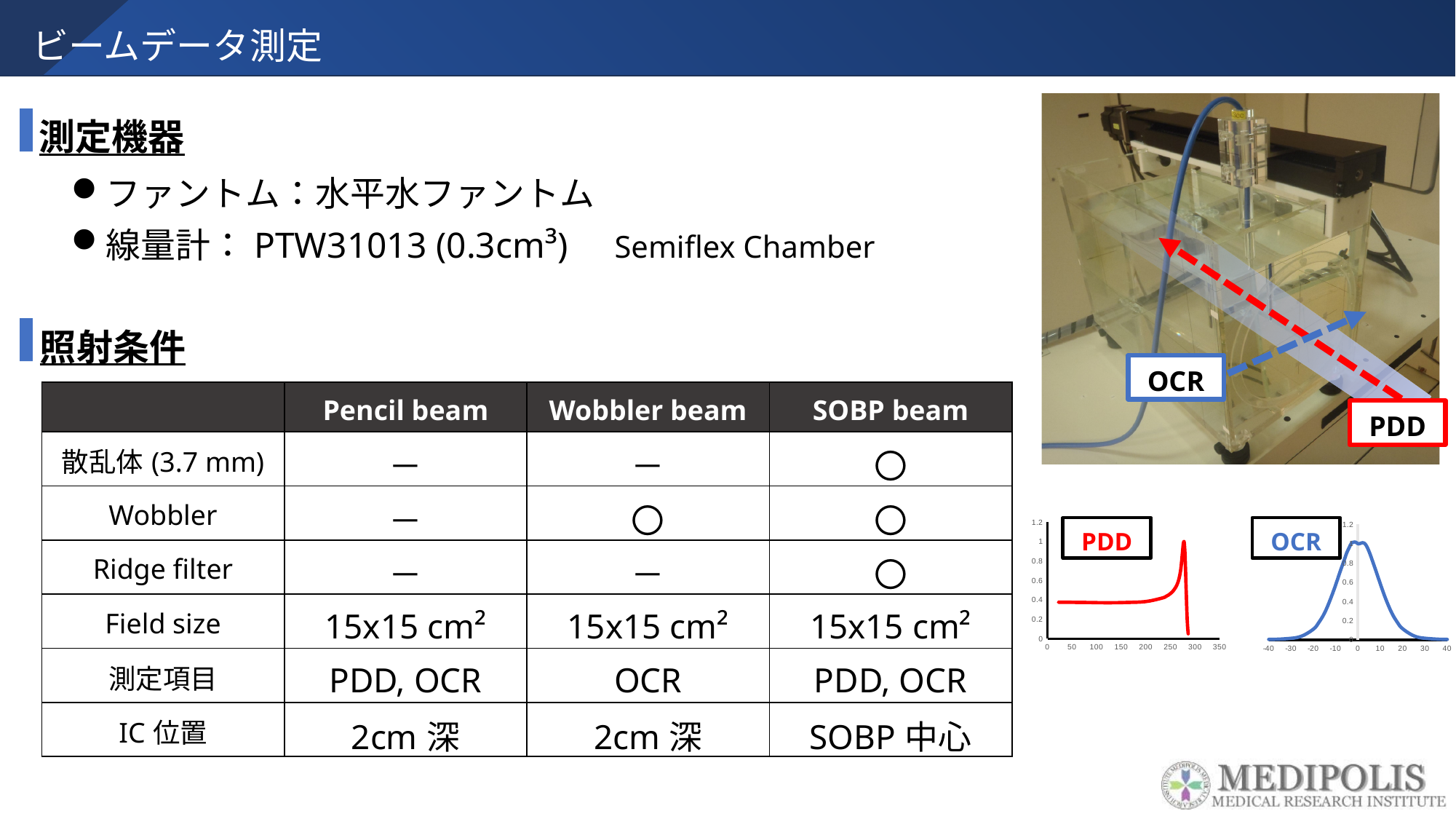
What is the largest x-axis tick value shown on the PDD chart? 350 What kind of chart is the OCR chart? line chart In the PDD chart, is the value at x = 50 greater or less than 0.6? less In the PDD chart, does the curve rise or fall as x increases from 0 to about 250? rise In the OCR chart, does the curve rise or fall as x increases from 0 to 40? fall How many charts are shown on the slide? 2 What kind of chart is the PDD chart? line chart In the OCR chart, is the value at x = -40 greater or less than 0.2? less In the PDD chart, is the peak value greater or less than 0.8? greater What colour is the line in the PDD chart? red